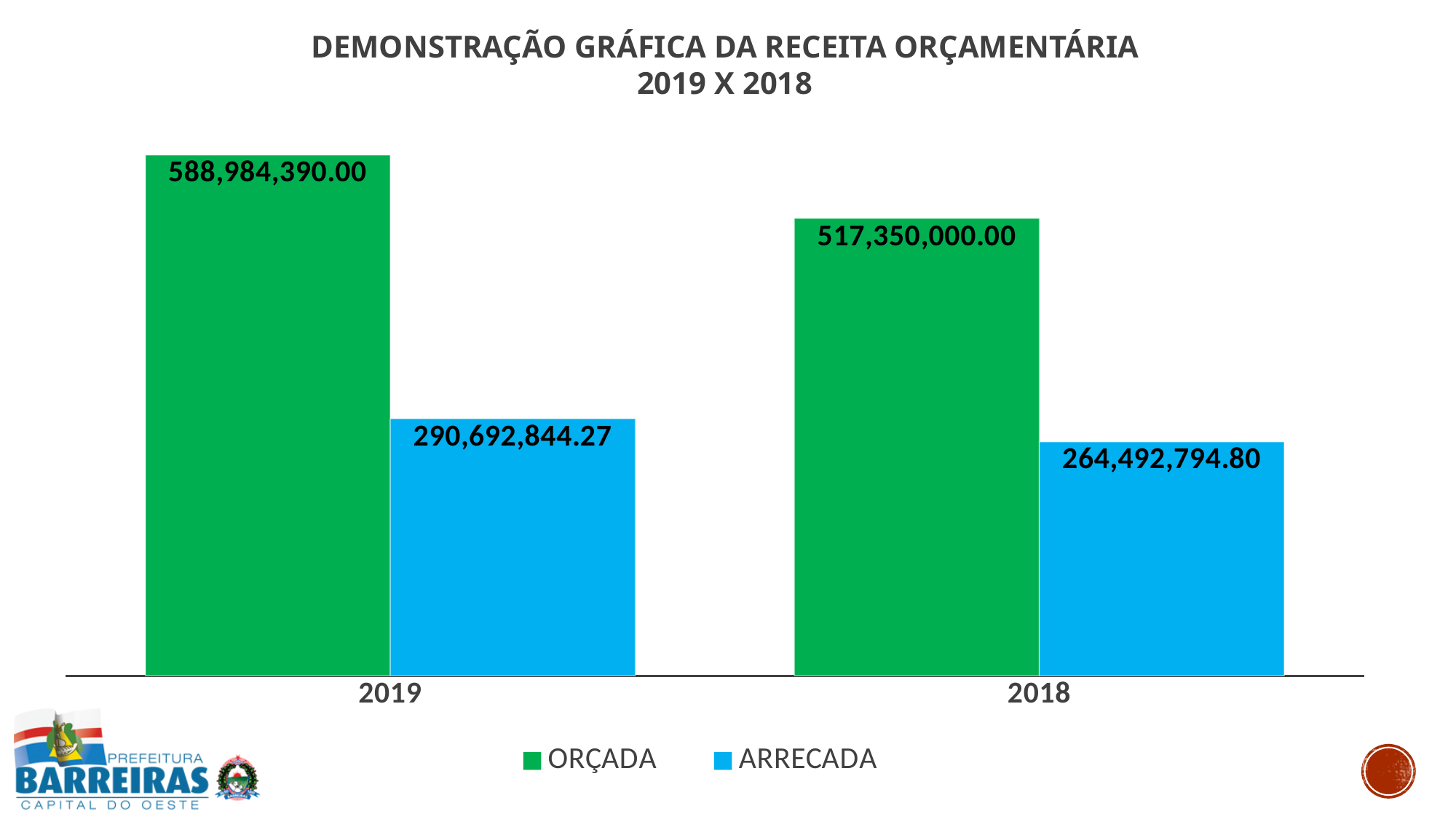
What is the ARRECADA value for 2019? 290,692,844.27 Which is larger, the ARRECADA value for 2019 or the ARRECADA value for 2018? 2019 What is the difference between the ORÇADA values for 2019 and 2018? 71,634,390.00 How many series does the legend list? 2 What is the difference between the ORÇADA and ARRECADA values for 2019? 298,291,545.73 What is the ORÇADA value for 2018? 517,350,000.00 What is the ORÇADA value for 2019? 588,984,390.00 How many years are shown on the x axis? 2 Which year has the highest ORÇADA value? 2019 What kind of chart is shown on the slide? bar chart What is the ARRECADA value for 2018? 264,492,794.80 Which year has the lowest ARRECADA value? 2018